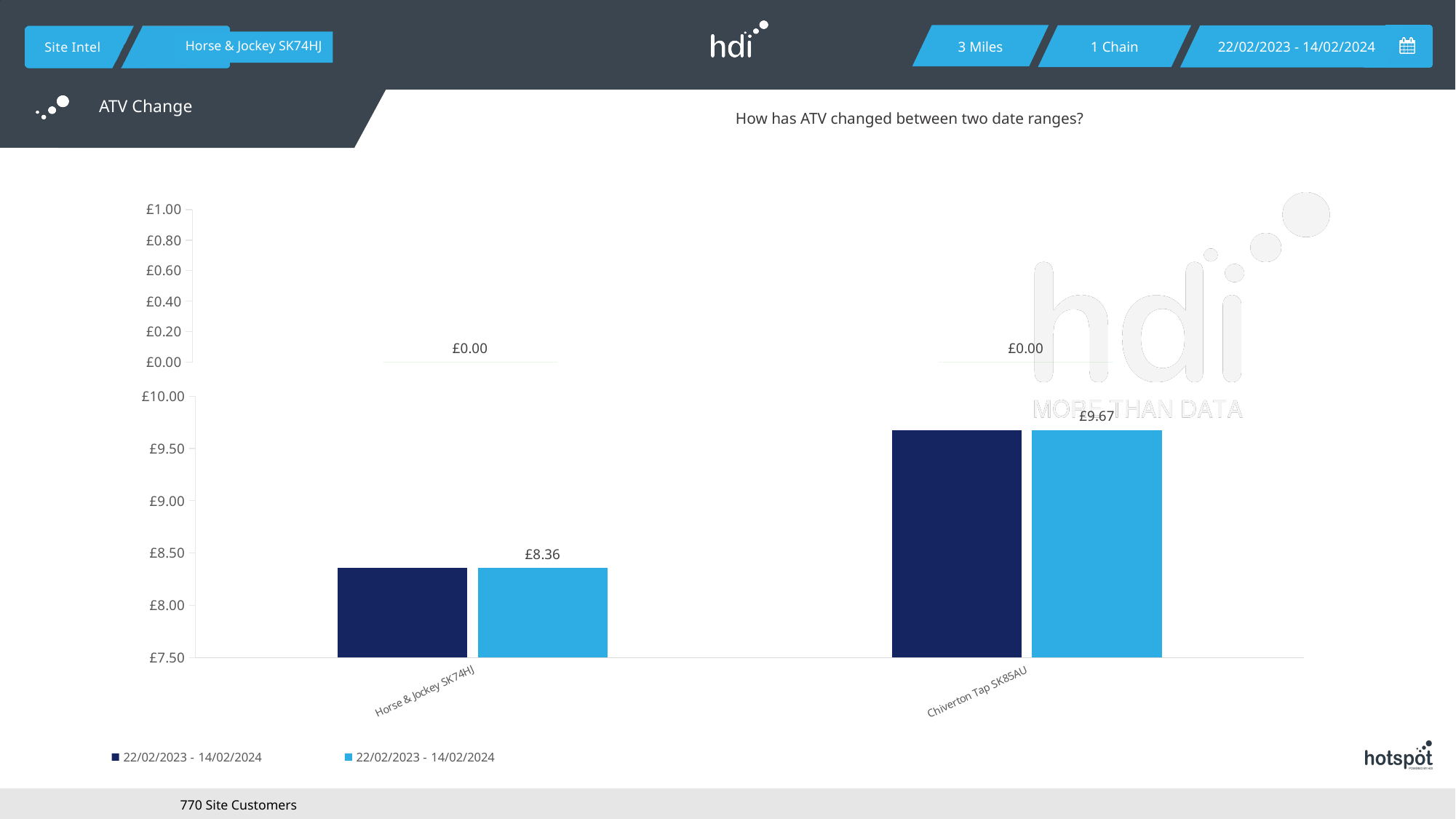
In the bottom chart, which site has the higher ATV? Chiverton Tap SK85AU In the bottom chart, what is the difference between the labelled ATV of Chiverton Tap SK85AU and Horse & Jockey SK74HJ? £1.31 In the bottom chart, is the ATV for Horse & Jockey SK74HJ greater or less than £8.50? less How many sites are shown on the x axis of the bottom chart? 2 In the bottom chart, is the ATV for Chiverton Tap SK85AU greater or less than £9.50? greater What type of chart is the bottom chart? bar chart In the bottom chart, what is the labelled ATV value for Horse & Jockey SK74HJ? £8.36 In the bottom chart, which site has the lower ATV? Horse & Jockey SK74HJ In the bottom chart, what is the labelled ATV value for Chiverton Tap SK85AU? £9.67 How many series does the legend of the bottom chart list? 2 In the top chart, what is the labelled change value for Horse & Jockey SK74HJ? £0.00 In the top chart, what is the labelled change value for Chiverton Tap SK85AU? £0.00